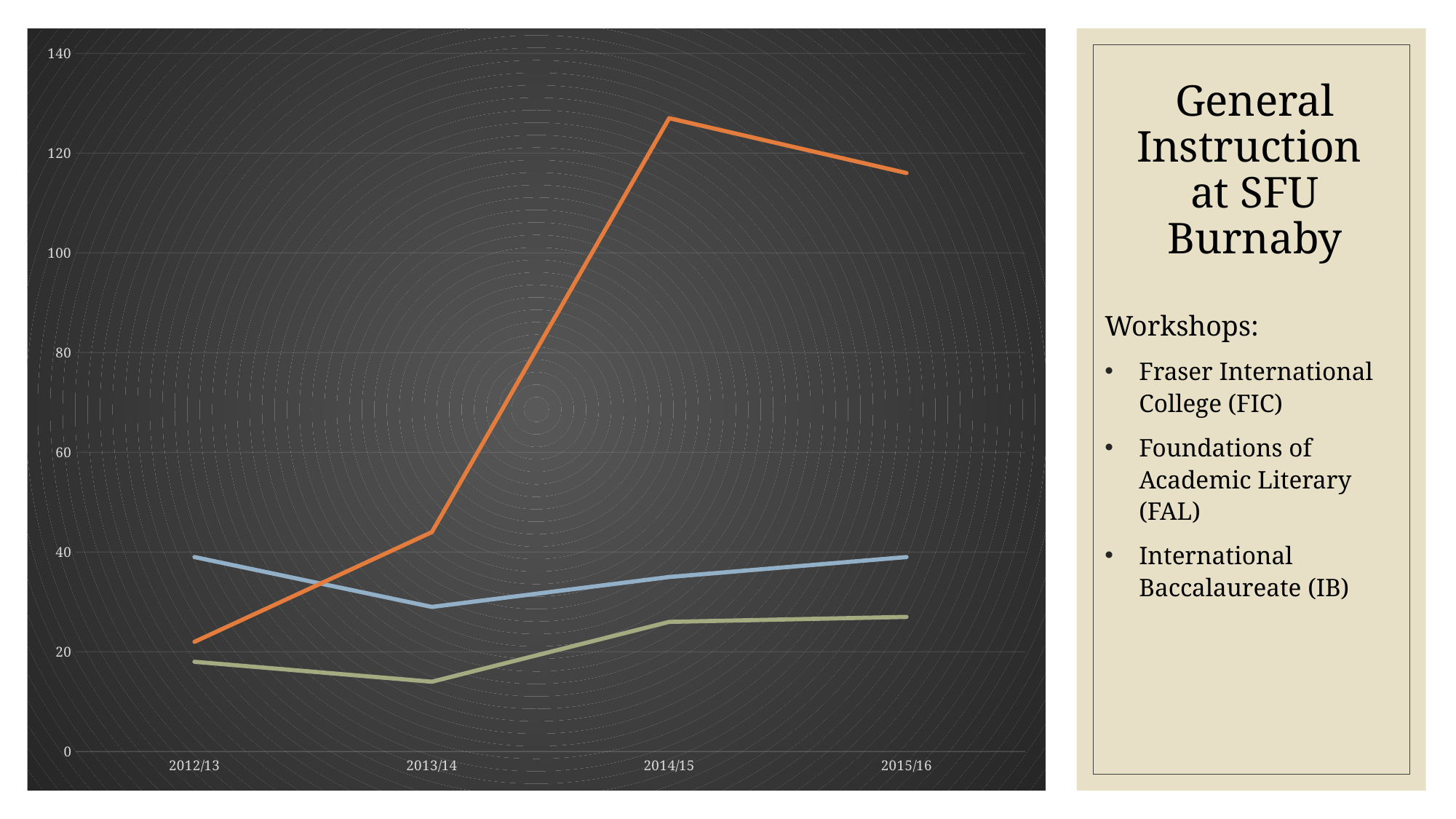
Is the value of the orange line for 2013/14 greater or less than 60? less What kind of chart is shown on the slide? line chart In which year is the orange line at its lowest value? 2012/13 Is the value of the blue line for 2013/14 greater or less than 40? less In which year does the orange line reach its highest value? 2014/15 At 2012/13, which line has the higher value, the blue line or the orange line? blue line Does the orange line rise or fall between 2013/14 and 2014/15? rise Is the value of the green line for 2013/14 greater or less than 20? less How many academic years are shown along the x axis of the chart? 4 How many lines are plotted on the chart? 3